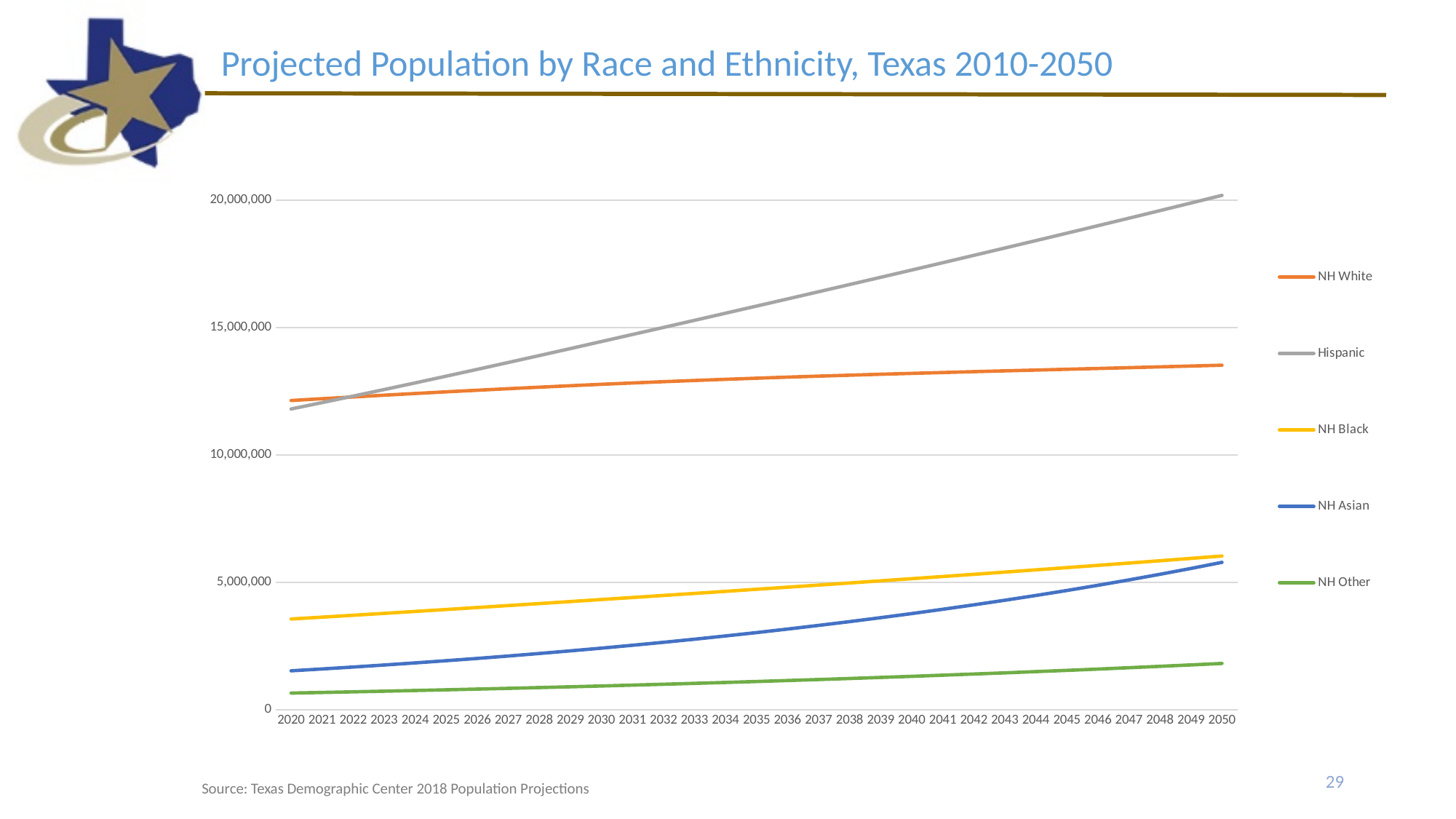
How many years are shown along the x axis? 31 Which group has the lowest projected population in 2050? NH Other Which group has the highest projected population in 2050? Hispanic In 2050, which is larger: the value for NH White or the value for Hispanic? Hispanic What is the title of the chart? Projected Population by Race and Ethnicity, Texas 2010-2050 Which group has the highest projected population in 2020? NH White Is the value for Hispanic in 2020 greater or less than 15,000,000? less Does the Hispanic line rise or fall from 2020 to 2050? Rise Is the value for NH Asian in 2050 greater or less than 5,000,000? greater How many series does the legend list? 5 What kind of chart is shown on the slide? Line chart Is the value for NH White in 2050 greater or less than 15,000,000? less